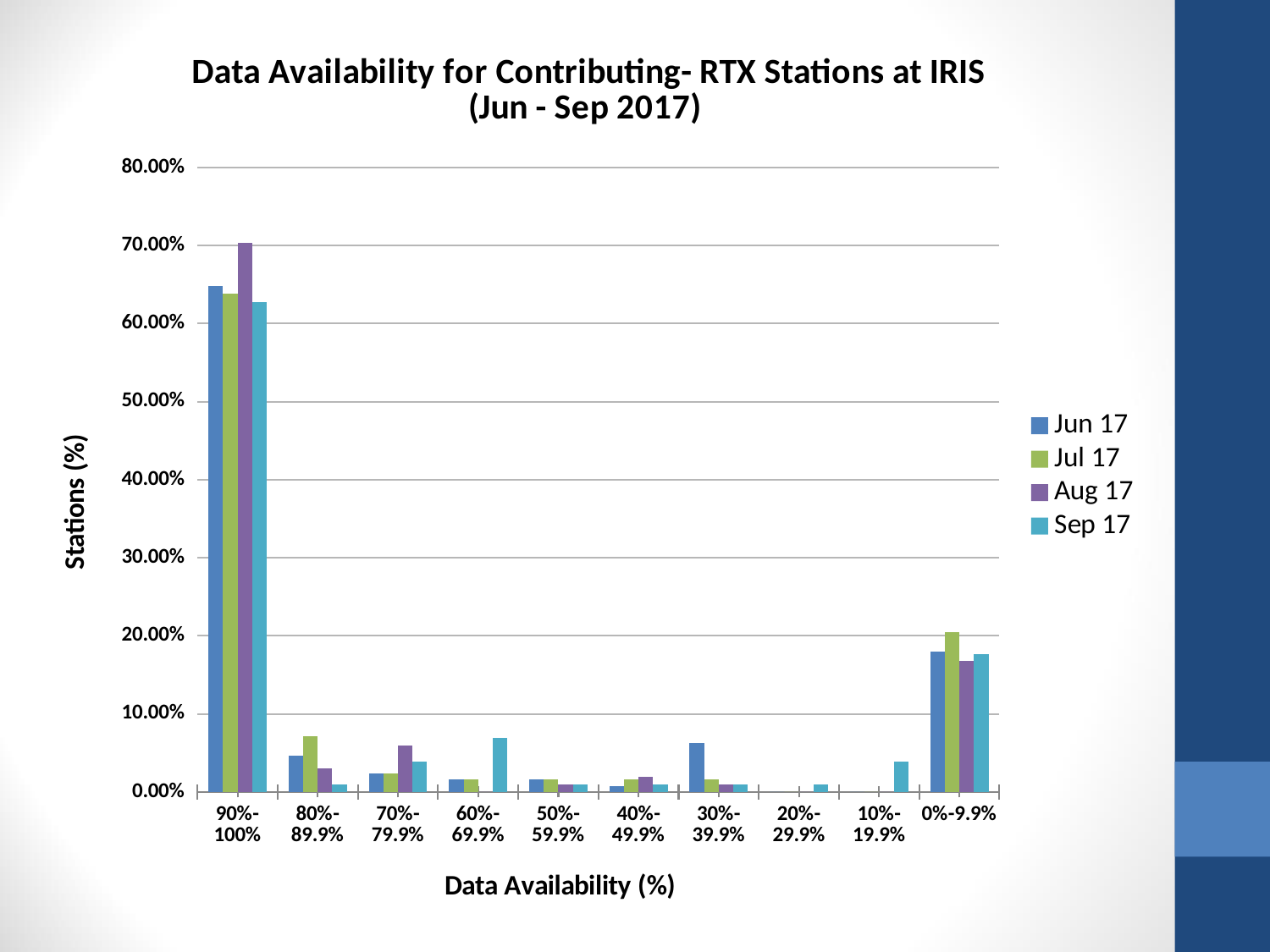
What kind of chart is shown on the slide? bar chart In the 0%-9.9% category, which is larger: Jul 17 or Aug 17? Jul 17 In the 80%-89.9% category, which series has the highest value? Jul 17 In the 90%-100% category, which series has the highest value? Aug 17 How many series does the legend list? 4 What is the title of the y axis? Stations (%) Which data availability category has the highest value for Aug 17? 90%-100% How many data availability categories are shown on the x axis? 10 In the 80%-89.9% category, which series has the lowest value? Sep 17 Is the value for Aug 17 in the 90%-100% category greater or less than 60.00%? greater Is the value for Jun 17 in the 0%-9.9% category greater or less than 20.00%? less